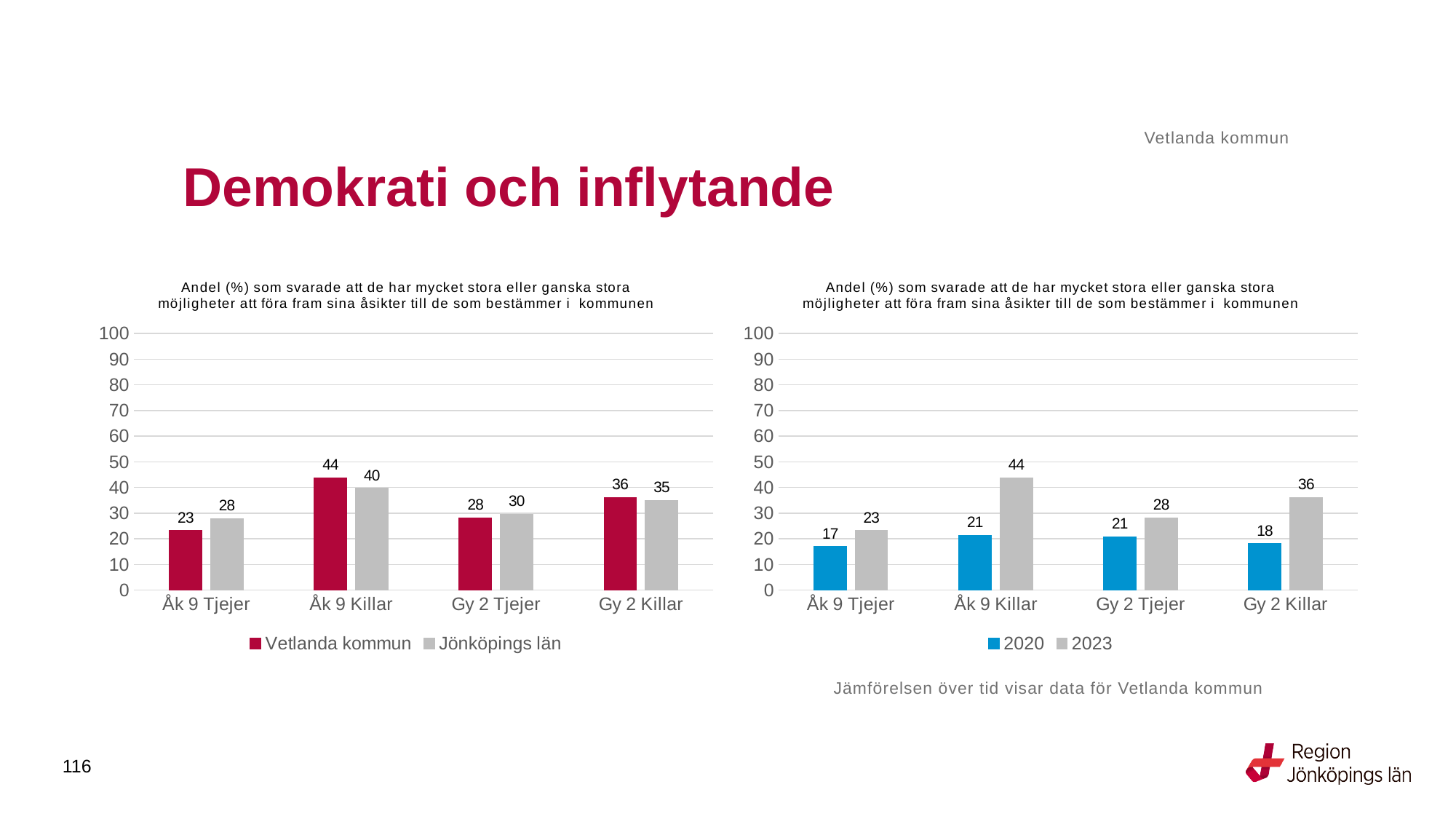
In the left chart, which is larger for Gy 2 Killar: Vetlanda kommun or Jönköpings län? Vetlanda kommun In the left chart, what is the value for Vetlanda kommun for Åk 9 Killar? 44 What kind of chart is the right chart? Bar chart In the right chart, which category has the highest value for 2023? Åk 9 Killar In the right chart, what is the difference between 2023 and 2020 for Åk 9 Killar? 23 How many categories are shown on the x axis of the right chart? 4 In the left chart, which category has the lowest value for Vetlanda kommun? Åk 9 Tjejer In the left chart, what is the difference between Vetlanda kommun and Jönköpings län for Åk 9 Tjejer? 5 In the left chart, what is the value for Jönköpings län for Gy 2 Tjejer? 30 In the right chart, which years are listed in the legend? 2020 and 2023 How many series does the legend of the left chart list? 2 In the right chart, what is the value for 2020 for Gy 2 Killar? 18